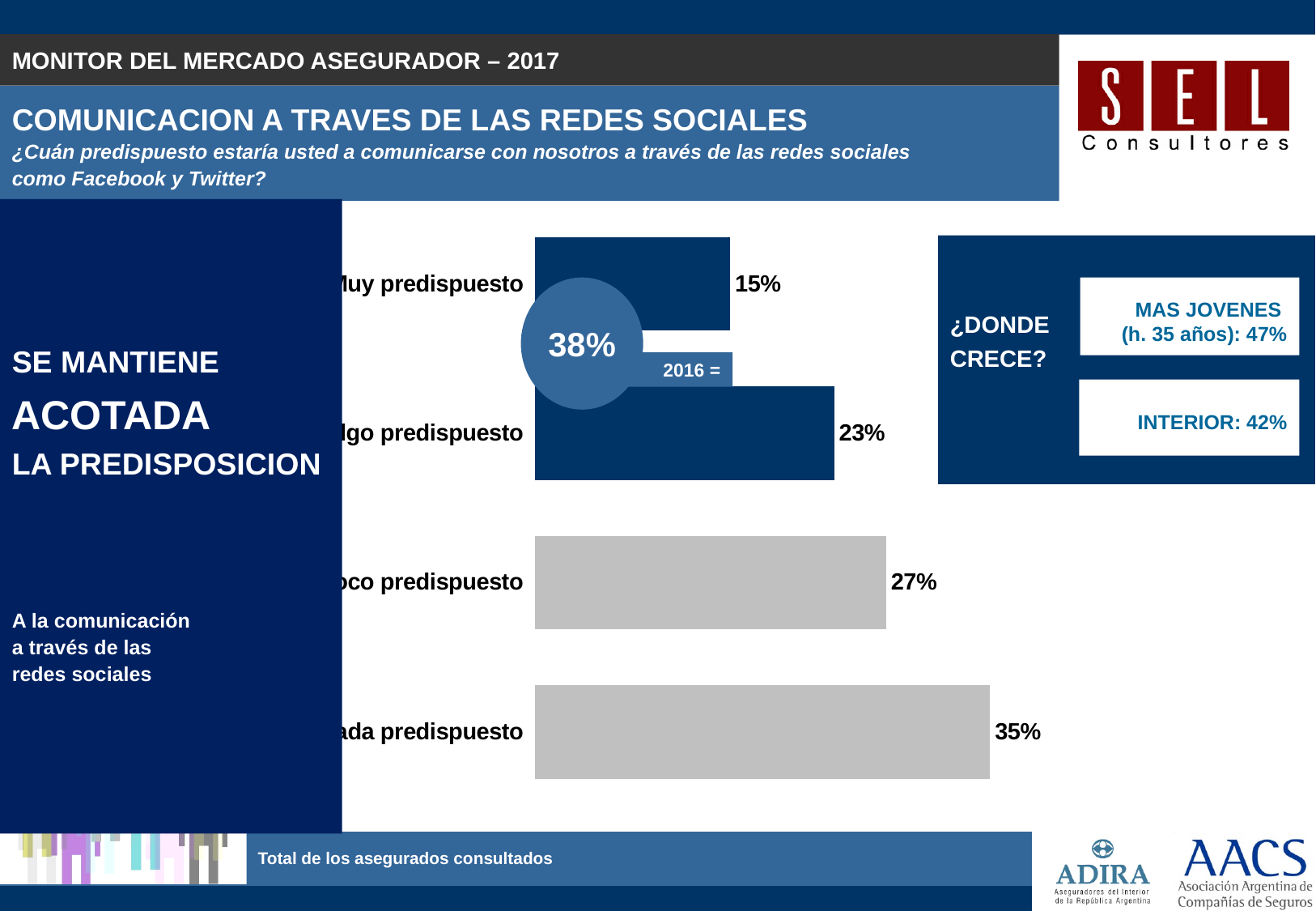
What percentage of respondents are "Nada predispuesto"? 35% Which category has the lowest percentage? Muy predispuesto Which category has the highest percentage? Nada predispuesto How many categories does the bar chart show? 4 Which is larger, the value for "Poco predispuesto" or the value for "Algo predispuesto"? Poco predispuesto What percentage of respondents are "Muy predispuesto"? 15% What combined percentage is shown in the circle over the two dark blue bars? 38% What kind of chart is shown on the slide? Bar chart What is the combined total of "Muy predispuesto" and "Algo predispuesto"? 38% What percentage of respondents are "Poco predispuesto"? 27% What is the difference in percentage points between "Nada predispuesto" and "Muy predispuesto"? 20 What percentage of respondents are "Algo predispuesto"? 23%